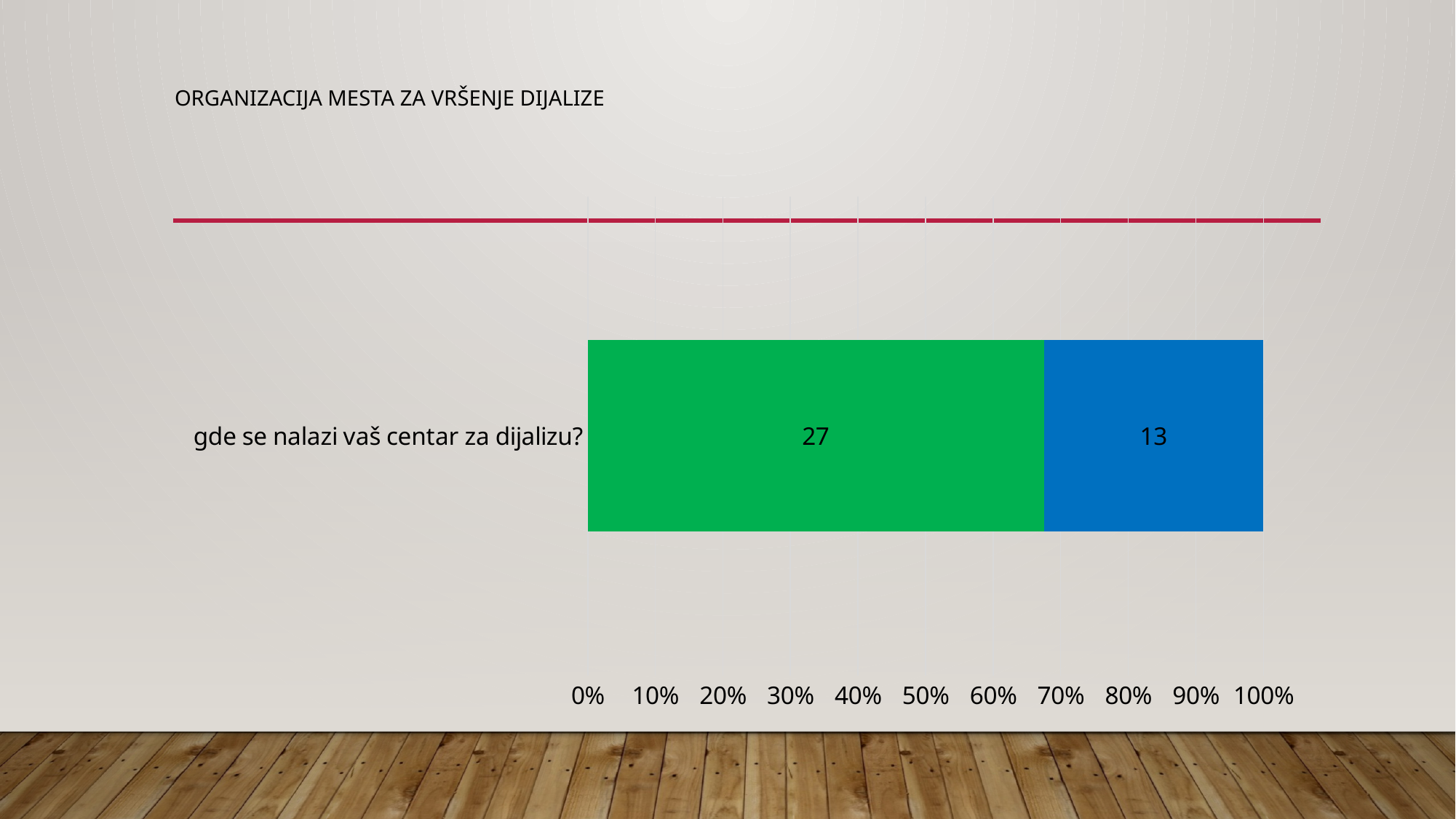
What kind of chart is shown on the slide? a stacked bar chart Does the green segment end at a point greater or less than 50% on the axis? greater What value is shown on the blue segment of the bar for "gde se nalazi vaš centar za dijalizu?"? 13 What is the difference between the green segment value and the blue segment value? 14 What is the title of the slide containing the chart? ORGANIZACIJA MESTA ZA VRŠENJE DIJALIZE Which segment of the bar is larger, the green one or the blue one? the green one What is the total of the two segments in the stacked bar? 40 What value is shown on the green segment of the bar for "gde se nalazi vaš centar za dijalizu?"? 27 How many segments make up the stacked bar? 2 Which segment has the smallest value in the bar? the blue segment (13) What is the highest tick label shown on the horizontal axis? 100% How many categories are plotted on the chart? 1